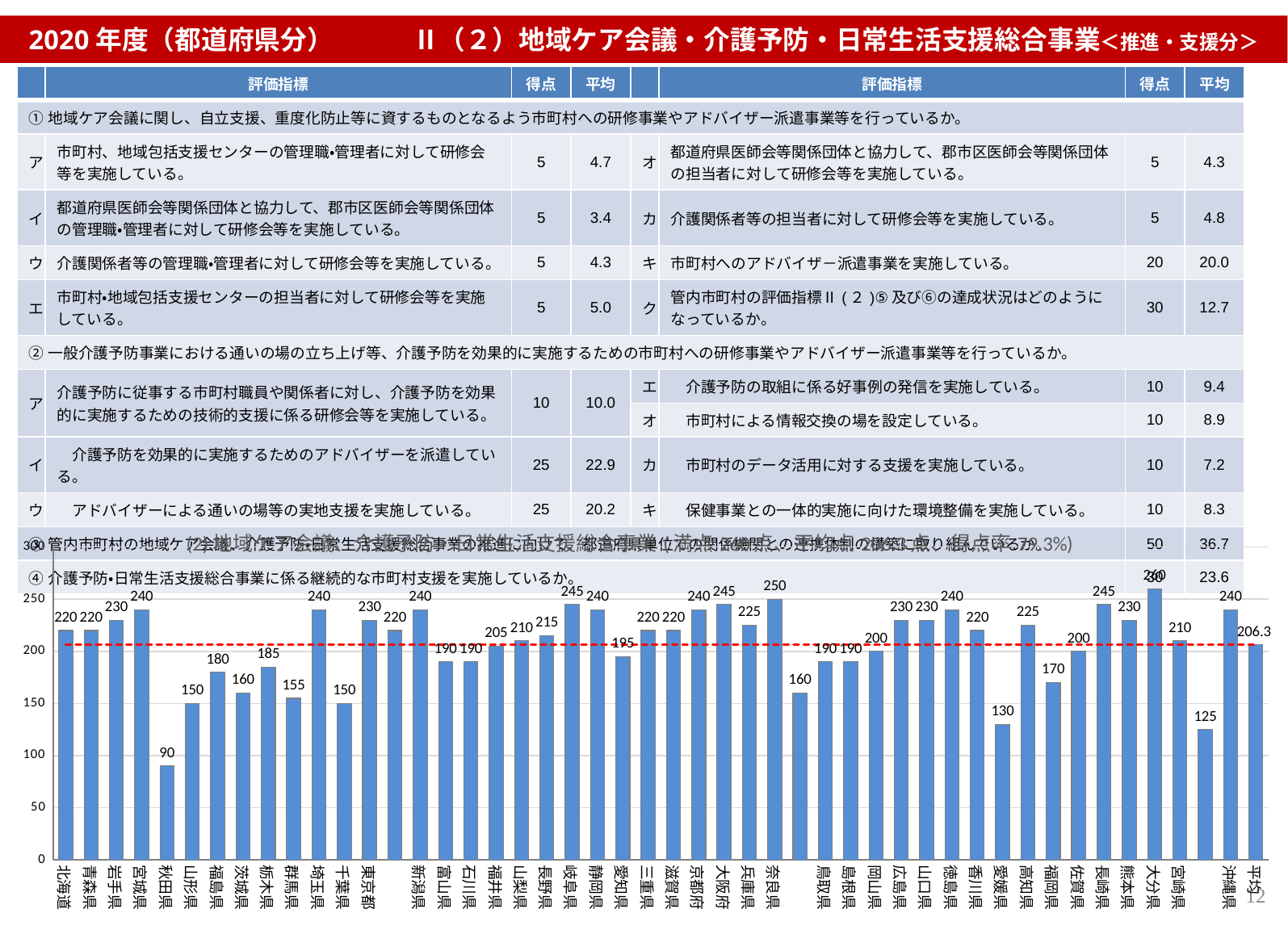
What kind of chart is shown at the bottom of the slide? bar chart What is the value for 奈良県 in the bar chart? 250 Is the value for 愛媛県 greater or less than 150? less What is the value for 秋田県 in the bar chart? 90 Which prefecture has the highest bar in the bar chart? 大分県 What colour are the bars in the chart? blue What is the value shown for 平均 at the right end of the bar chart? 206.3 What is the difference between the values for 宮城県 and 秋田県? 150 What is the difference between the values for 奈良県 and 愛媛県? 120 Which has the larger value, 福島県 or 茨城県? 福島県 Which prefecture has the lowest value in the bar chart? 秋田県 What is the value for 岐阜県 in the bar chart? 245